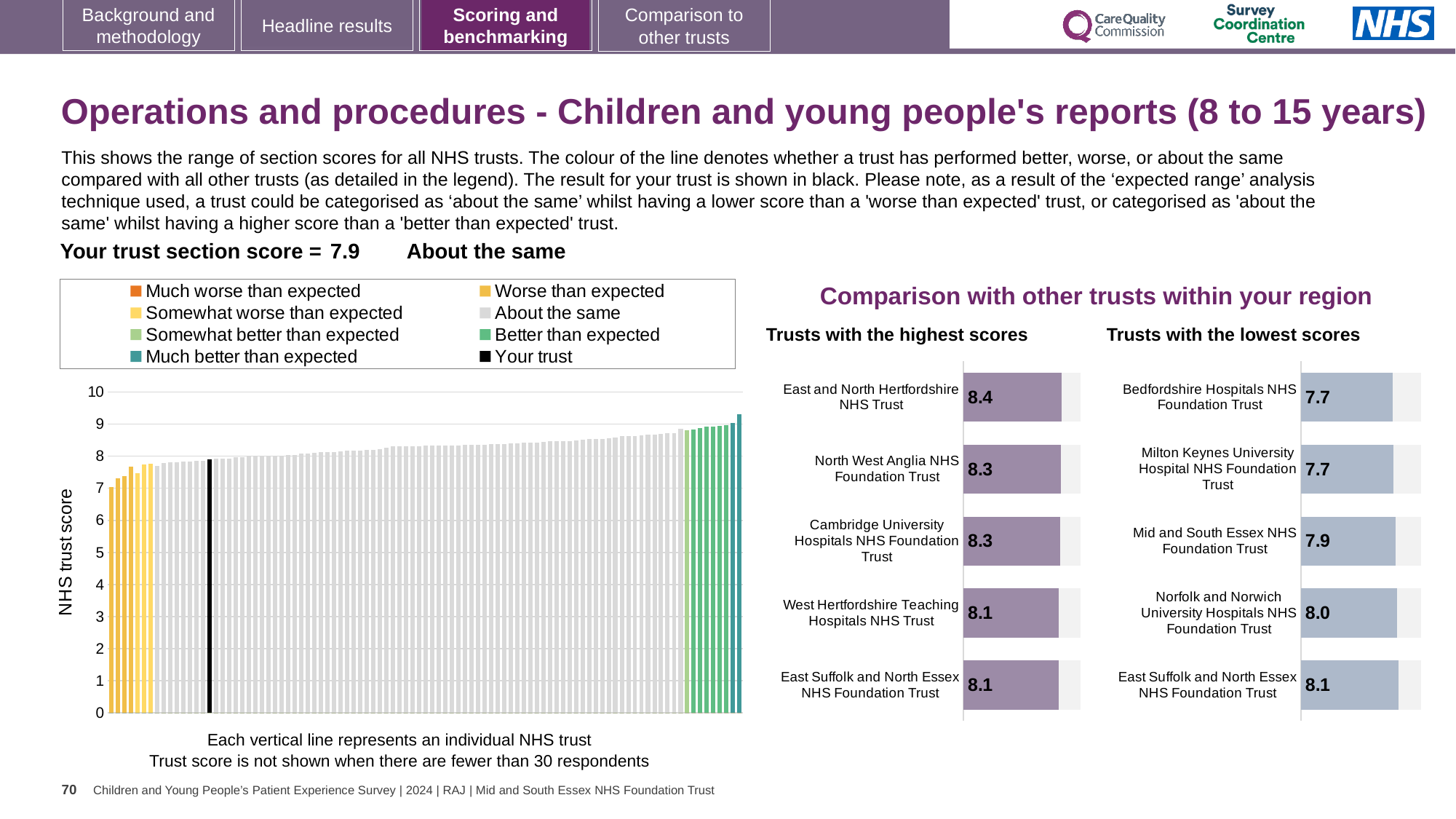
In the 'Trusts with the highest scores' chart, what is the score for East and North Hertfordshire NHS Trust? 8.4 In the 'NHS trust score' chart on the left, do the bar values rise or fall from left to right? Rise In the 'Trusts with the lowest scores' chart, what is the score for Mid and South Essex NHS Foundation Trust? 7.9 What kind of chart is the 'NHS trust score' chart on the left of the slide? Bar chart In the 'NHS trust score' chart on the left, is the value of the tallest bar greater or less than 9? greater In the 'Trusts with the highest scores' chart, which trust has the highest score? East and North Hertfordshire NHS Trust In the 'Trusts with the highest scores' chart, what is the difference between the scores of East and North Hertfordshire NHS Trust and West Hertfordshire Teaching Hospitals NHS Trust? 0.3 In the 'Trusts with the lowest scores' chart, which trust has the highest score? East Suffolk and North Essex NHS Foundation Trust In the 'Trusts with the lowest scores' chart, what is the difference between the scores of East Suffolk and North Essex NHS Foundation Trust and Bedfordshire Hospitals NHS Foundation Trust? 0.4 In the 'Trusts with the highest scores' chart, how many trusts are listed? 5 In the 'Trusts with the lowest scores' chart, which has the larger score: Mid and South Essex NHS Foundation Trust or Norfolk and Norwich University Hospitals NHS Foundation Trust? Norfolk and Norwich University Hospitals NHS Foundation Trust How many entries does the legend of the 'NHS trust score' chart on the left list? 8